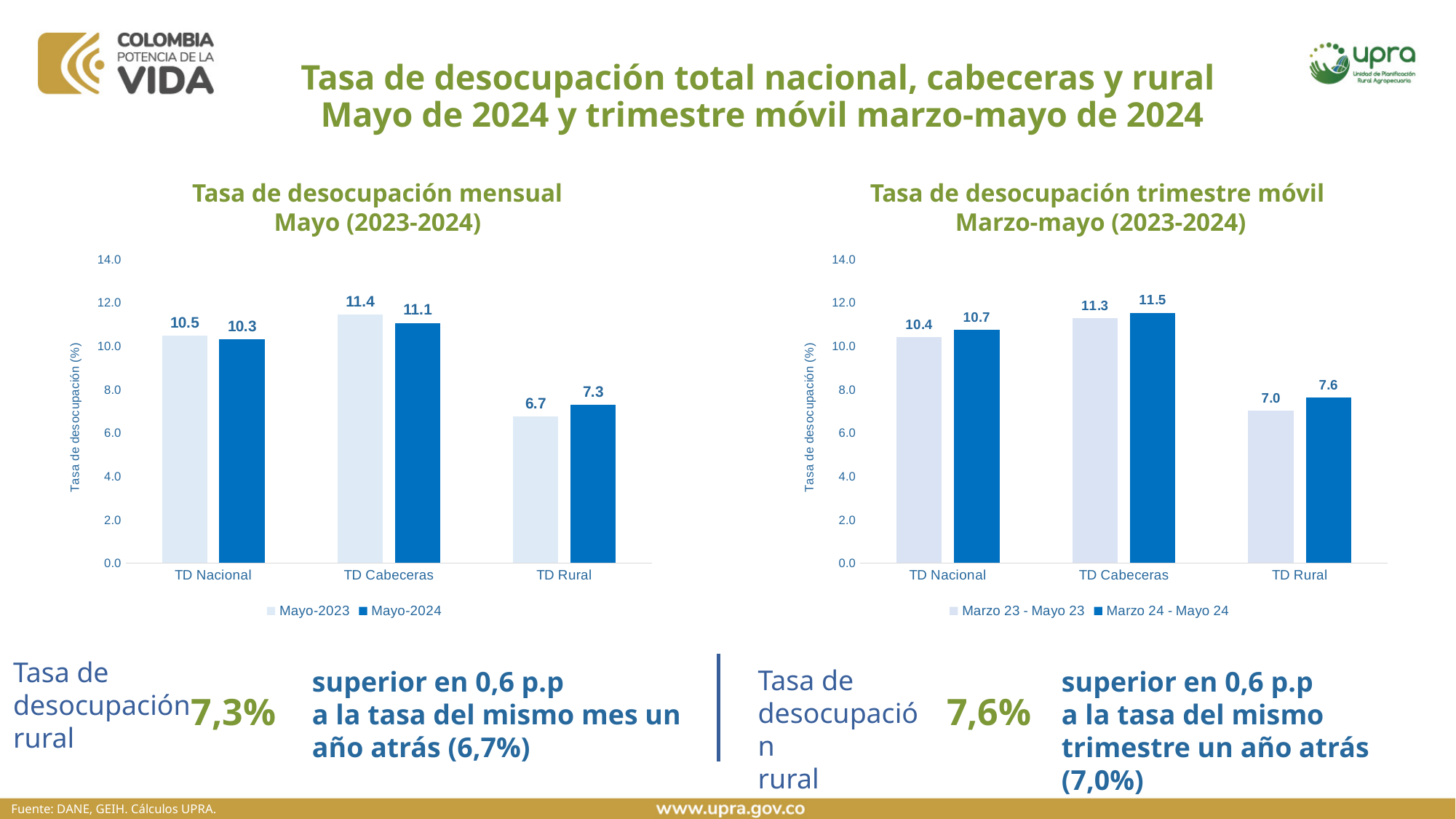
How many series does the legend of the 'Tasa de desocupación mensual Mayo (2023-2024)' chart list? 2 In the 'Tasa de desocupación trimestre móvil Marzo-mayo (2023-2024)' chart, what is the difference between the Marzo 24 - Mayo 24 and Marzo 23 - Mayo 23 values for TD Cabeceras? 0.2 How many categories are shown on the x axis of the 'Tasa de desocupación trimestre móvil Marzo-mayo (2023-2024)' chart? 3 In the 'Tasa de desocupación trimestre móvil Marzo-mayo (2023-2024)' chart, what is the value for TD Nacional in Marzo 24 - Mayo 24? 10.7 In the 'Tasa de desocupación trimestre móvil Marzo-mayo (2023-2024)' chart, which category has the lowest value for Marzo 24 - Mayo 24? TD Rural In the 'Tasa de desocupación trimestre móvil Marzo-mayo (2023-2024)' chart, what is the value for TD Rural in Marzo 23 - Mayo 23? 7.0 In the 'Tasa de desocupación mensual Mayo (2023-2024)' chart, which is larger for TD Nacional: Mayo-2023 or Mayo-2024? Mayo-2023 In the 'Tasa de desocupación mensual Mayo (2023-2024)' chart, what is the difference between the Mayo-2024 and Mayo-2023 values for TD Rural? 0.6 What type of chart is the 'Tasa de desocupación trimestre móvil Marzo-mayo (2023-2024)' chart? Bar chart In the 'Tasa de desocupación mensual Mayo (2023-2024)' chart, which category has the highest value for Mayo-2024? TD Cabeceras In the 'Tasa de desocupación mensual Mayo (2023-2024)' chart, what is the value for TD Rural in Mayo-2023? 6.7 In the 'Tasa de desocupación mensual Mayo (2023-2024)' chart, what is the value for TD Cabeceras in Mayo-2024? 11.1